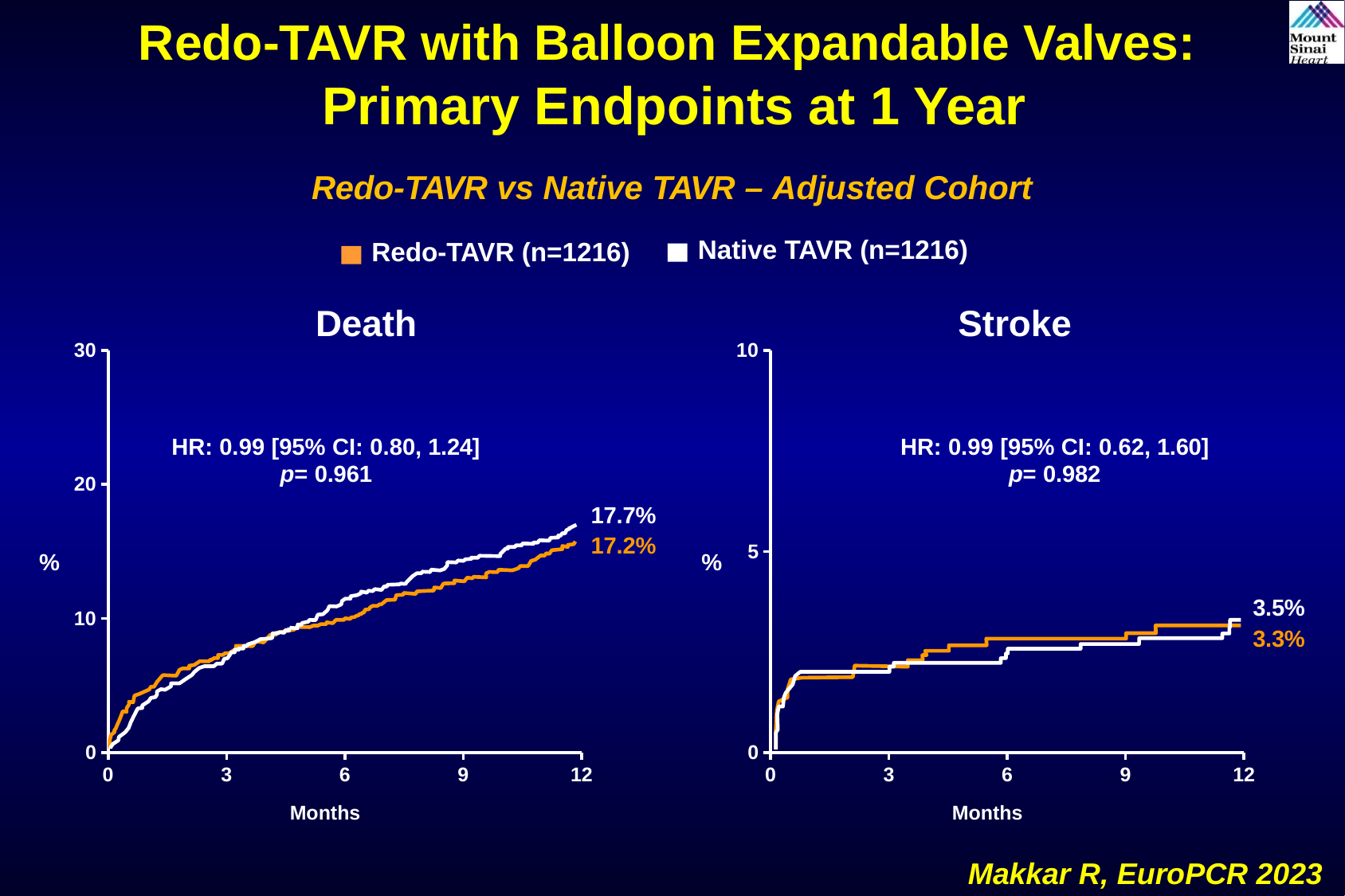
In the Stroke chart, what is the 1-year value for Redo-TAVR? 3.3% In the Death chart, what is the difference between the Native TAVR and Redo-TAVR values at 1 year? 0.5% In the Death chart, which group has the higher value at 1 year, Redo-TAVR or Native TAVR? Native TAVR In the Stroke chart, is the Redo-TAVR value at 12 months greater or less than 5? less In the Death chart, what is the 1-year value for Redo-TAVR? 17.2% How many series does the legend list? 2 In the Stroke chart, what is the 1-year value for Native TAVR? 3.5% In the Stroke chart, what is the difference between the Native TAVR and Redo-TAVR values at 1 year? 0.2% In the Death chart, what is the 1-year value for Native TAVR? 17.7% What is the hazard ratio shown on the Stroke chart? 0.99 [95% CI: 0.62, 1.60] In the Death chart, is the Native TAVR value at 12 months greater or less than 20? less In the Death chart, do the curves rise or fall over the months? rise